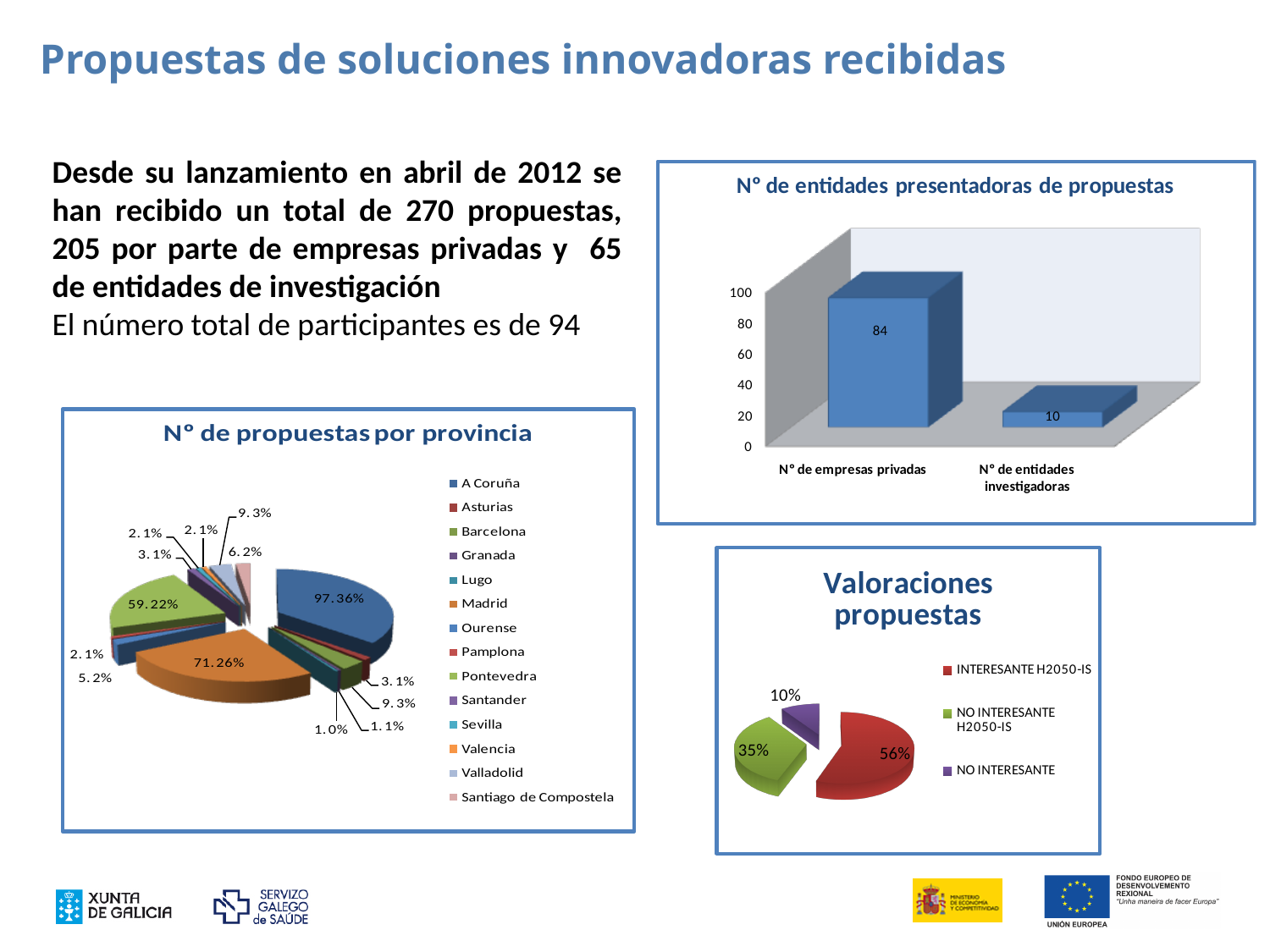
In the chart 'Valoraciones propuestas', what share is labelled NO INTERESANTE H2050-IS? 35% How many entries does the legend of the chart 'Valoraciones propuestas' list? 3 In the chart 'N° de entidades presentadoras de propuestas', what is the value for N° de entidades investigadoras? 10 What kind of chart is 'N° de propuestas por provincia'? pie chart In the chart 'Valoraciones propuestas', what share is labelled INTERESANTE H2050-IS? 56% In the chart 'N° de entidades presentadoras de propuestas', is the value for N° de empresas privadas greater or less than 80? greater In the chart 'Valoraciones propuestas', which category has the smallest slice? NO INTERESANTE How many entries does the legend of the chart 'N° de propuestas por provincia' list? 14 In the chart 'N° de entidades presentadoras de propuestas', which category has the higher value? N° de empresas privadas In the chart 'N° de entidades presentadoras de propuestas', what is the difference between the two bars? 74 What kind of chart is 'N° de entidades presentadoras de propuestas'? bar chart In the chart 'N° de entidades presentadoras de propuestas', what is the value for N° de empresas privadas? 84